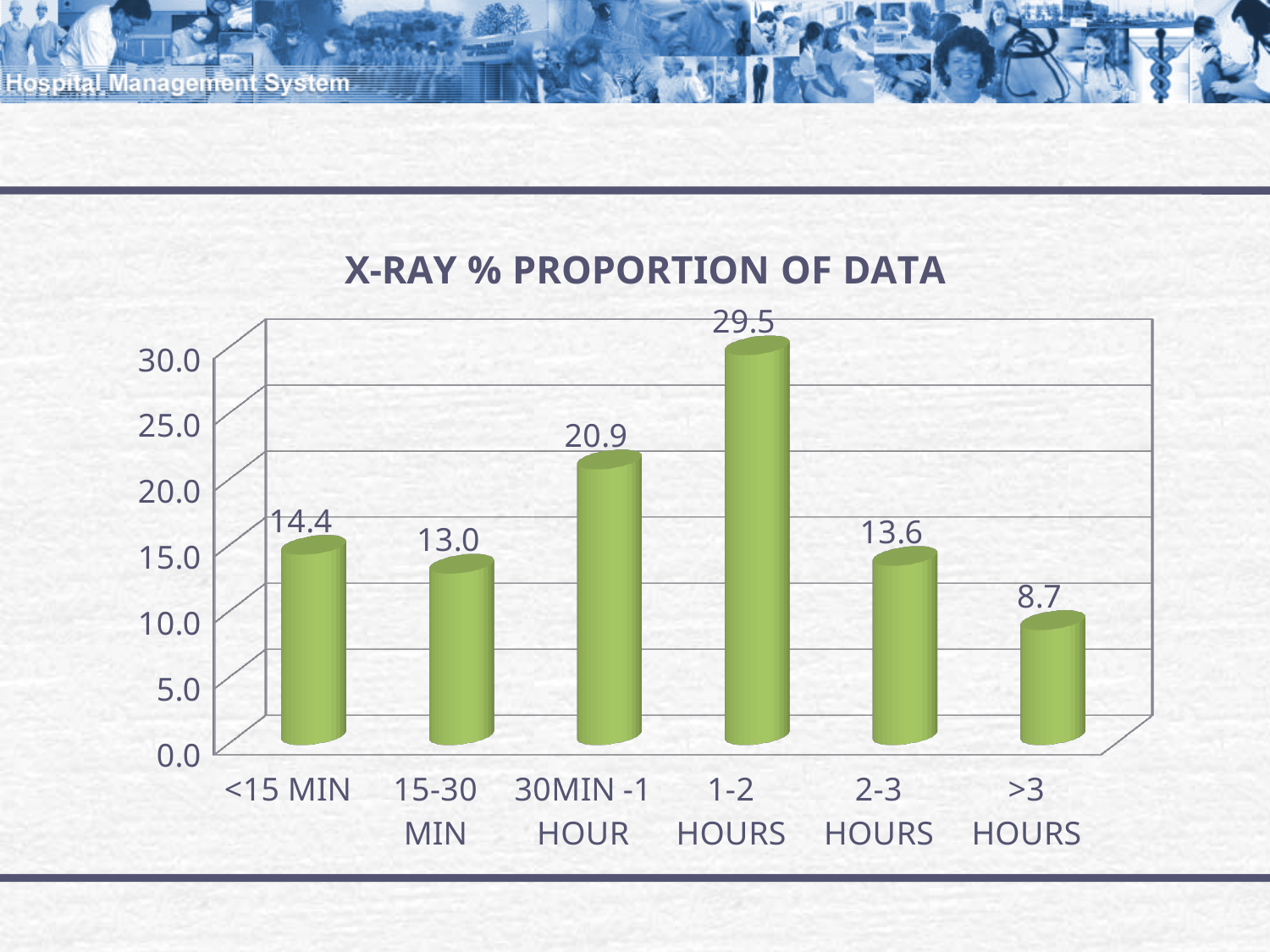
What is the value for the <15 MIN category? 14.4 What kind of chart is shown on the slide? bar chart Which is larger, the value for 15-30 MIN or the value for 2-3 HOURS? 2-3 HOURS Which category has the lowest value? >3 HOURS Is the value for 30MIN -1 HOUR greater or less than 20.0? greater What colour are the bars in the chart? green What is the value for the >3 HOURS category? 8.7 Which category has the highest value? 1-2 HOURS What is the title of the chart? X-RAY % PROPORTION OF DATA How many categories are shown on the x axis? 6 What is the difference between the values for 1-2 HOURS and 30MIN -1 HOUR? 8.6 What is the value for the 1-2 HOURS category? 29.5